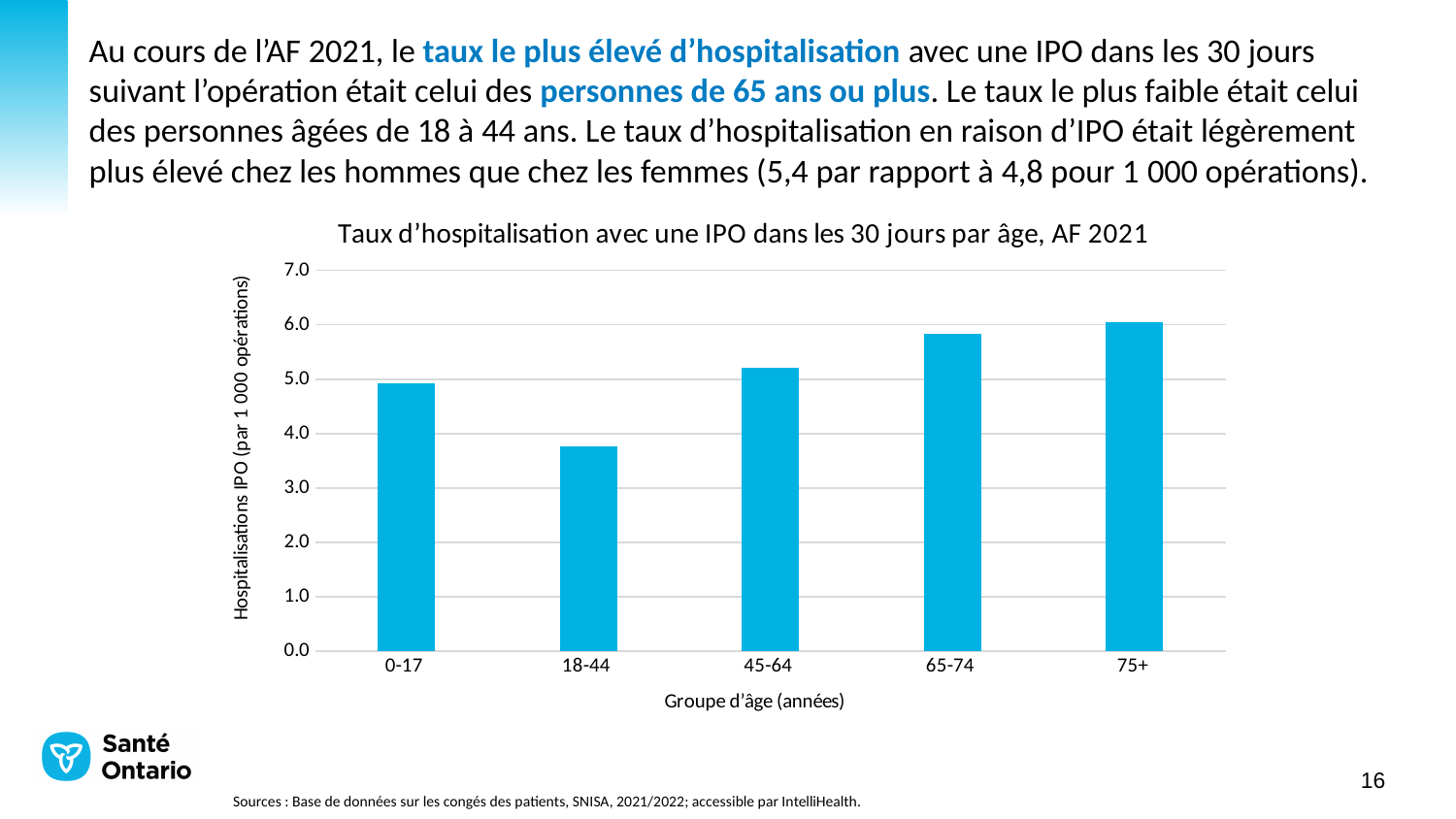
From the 18-44 group to the 75+ group, do the values rise or fall along the x axis? rise Is the value for the 45-64 age group greater or less than 5.0? greater What is the title of the chart? Taux d'hospitalisation avec une IPO dans les 30 jours par âge, AF 2021 Which has the higher hospitalisation rate, the 65-74 group or the 75+ group? 75+ What kind of chart is shown on the slide? bar chart Which age group has the highest hospitalisation rate in the chart? 75+ Is the value for the 18-44 age group greater or less than 4.0? less How many age groups are shown on the x axis of the chart? 5 Which has the higher hospitalisation rate, the 0-17 group or the 45-64 group? 45-64 Which age group has the lowest hospitalisation rate in the chart? 18-44